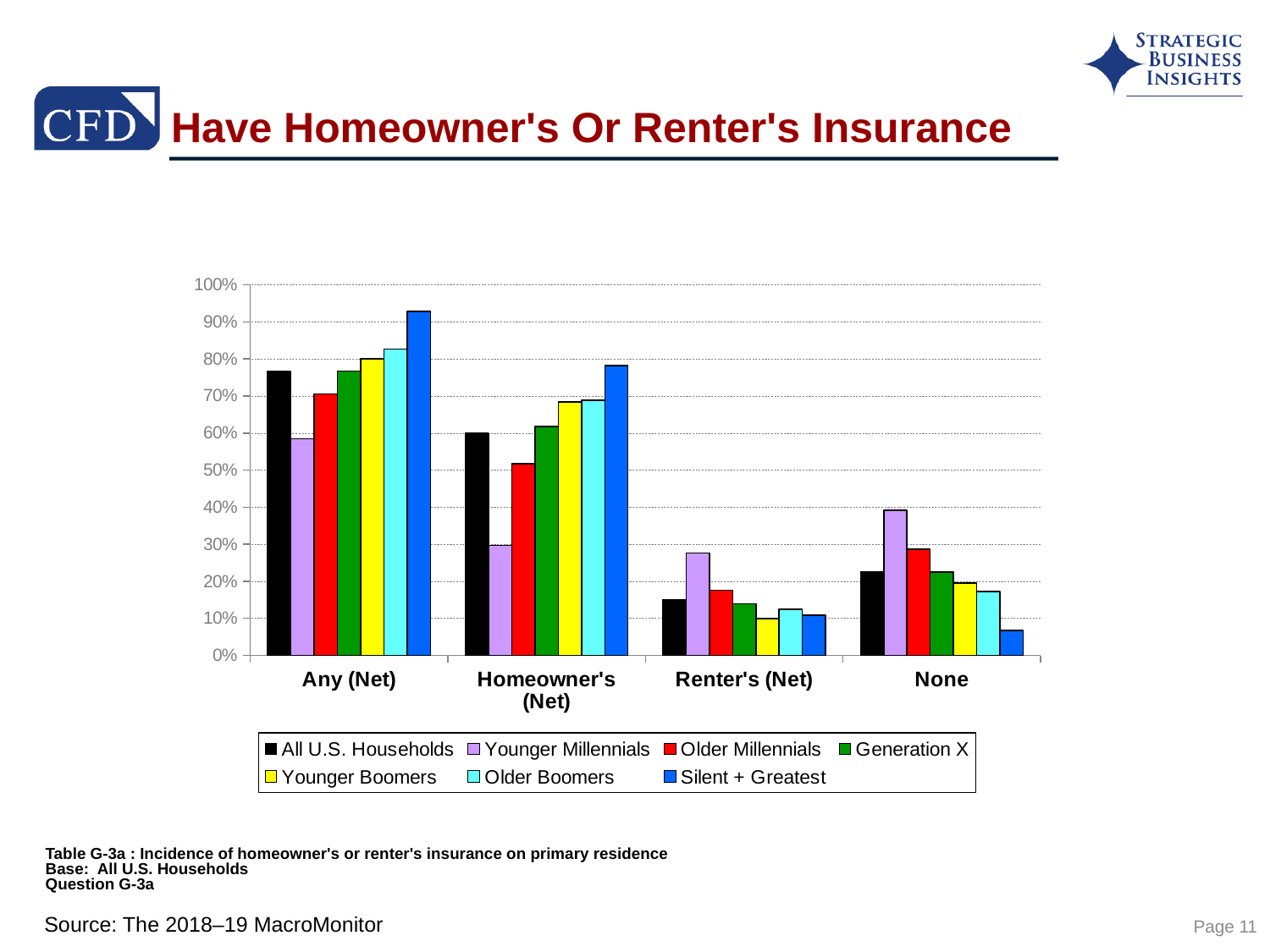
Is the value for Silent + Greatest in the Any (Net) category greater or less than 90%? greater In the None category, which series has the lowest value? Silent + Greatest How many categories are shown along the x axis? 4 In the Homeowner's (Net) category, which is larger: Silent + Greatest or Younger Millennials? Silent + Greatest In the None category, which series has the highest value? Younger Millennials How many series does the legend list? 7 In the Any (Net) category, which series has the lowest value? Younger Millennials Is the value for Younger Millennials in the Homeowner's (Net) category greater or less than 40%? less In the Renter's (Net) category, which series has the highest value? Younger Millennials In the Any (Net) category, which series has the highest value? Silent + Greatest What is the title of the slide's chart? Have Homeowner's Or Renter's Insurance What kind of chart is shown on the slide? bar chart